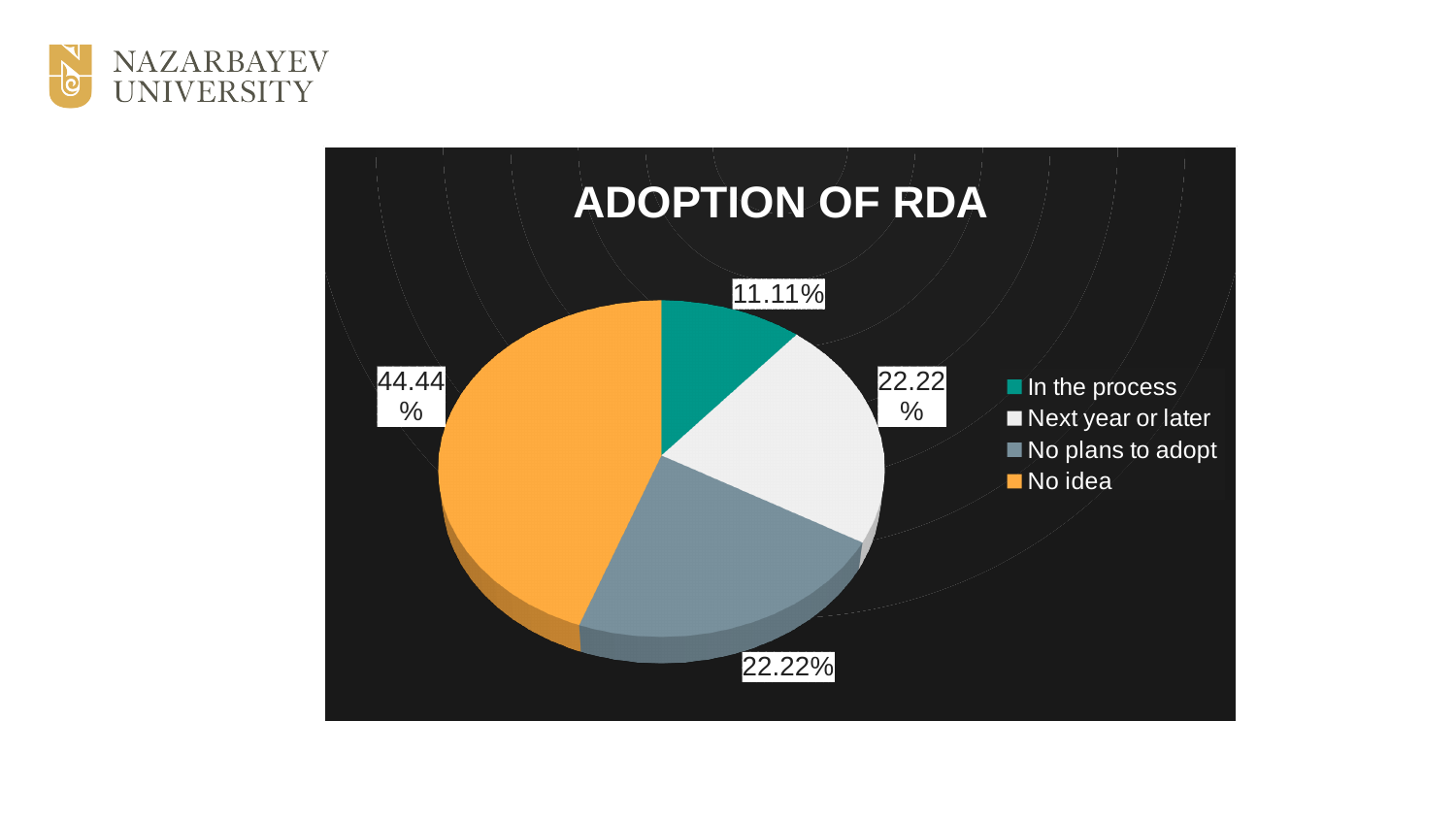
What type of chart is shown on the slide? Pie chart What percentage of the pie is labelled "In the process"? 11.11% How many categories does the legend list? 4 What percentage of the pie is labelled "No plans to adopt"? 22.22% What percentage of the pie is labelled "Next year or later"? 22.22% What is the difference in percentage points between the "No idea" share and the "In the process" share? 33.33 percentage points What colour is the "No idea" slice? Orange Which category has the smallest share of the pie? In the process Which category has the largest share of the pie? No idea Which is larger: the share for "No idea" or the share for "In the process"? No idea What is the title of the chart? ADOPTION OF RDA What percentage of the pie is labelled "No idea"? 44.44%